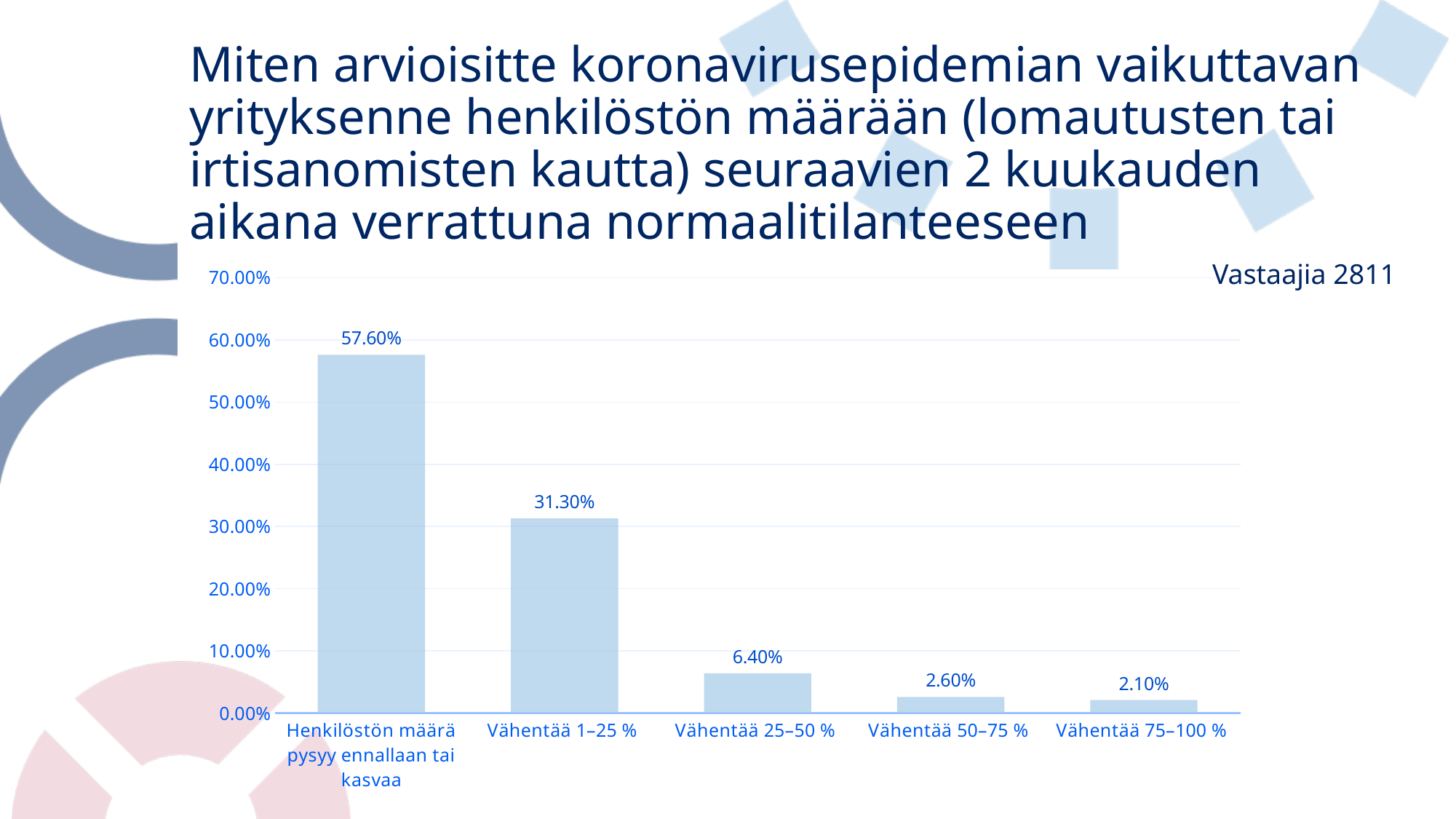
Which is larger, the value for "Vähentää 25–50 %" or "Vähentää 50–75 %"? Vähentää 25–50 % What is the difference between the values for "Henkilöstön määrä pysyy ennallaan tai kasvaa" and "Vähentää 1–25 %"? 26.30% Which category has the highest value? Henkilöstön määrä pysyy ennallaan tai kasvaa Which category has the lowest value? Vähentää 75–100 % How many categories are shown on the x axis? 5 What is the value for "Vähentää 25–50 %"? 6.40% What is the value for "Henkilöstön määrä pysyy ennallaan tai kasvaa"? 57.60% What kind of chart is shown on the slide? bar chart What is the value for "Vähentää 75–100 %"? 2.10% How many respondents (Vastaajia) does the slide report? 2811 What is the value for "Vähentää 1–25 %"? 31.30% Is the value for "Vähentää 1–25 %" greater or less than 40.00%? less